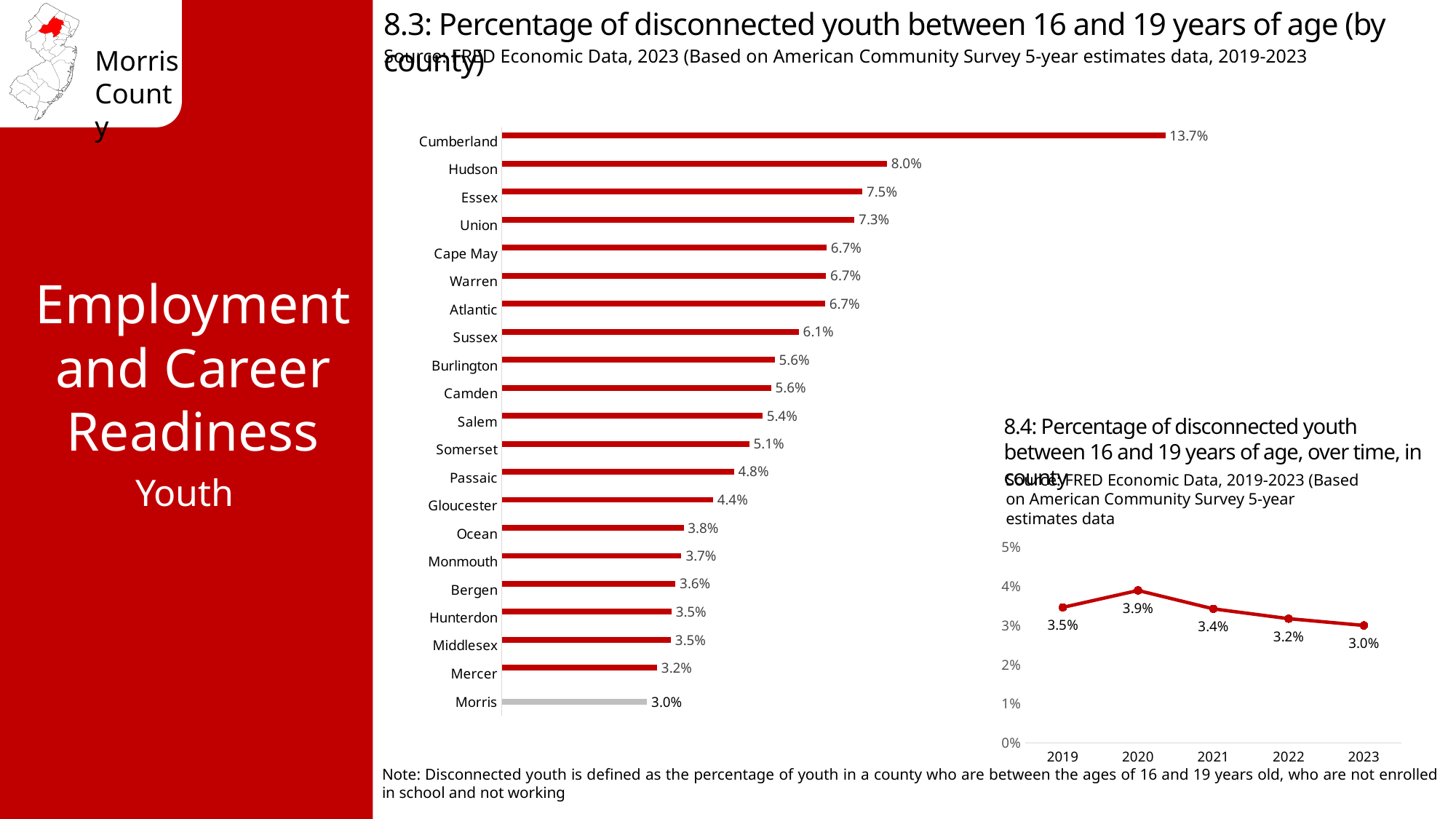
In the 8.3 bar chart (by county), which bar is coloured grey instead of red? Morris In the 8.3 bar chart (by county), which county has the highest percentage of disconnected youth? Cumberland What kind of chart is chart 8.3 (by county)? Bar chart In the 8.4 line chart (over time), what is the value for 2020? 3.9% In the 8.4 line chart (over time), which year has the lowest value? 2023 In the 8.3 bar chart (by county), which is larger, the value for Sussex or the value for Salem? Sussex How many counties are shown in the 8.3 bar chart (by county)? 21 In the 8.3 bar chart (by county), what is the value for Morris? 3.0% In the 8.3 bar chart (by county), what is the value for Cumberland? 13.7% In the 8.4 line chart (over time), do the values rise or fall from 2020 to 2023? Fall In the 8.3 bar chart (by county), what is the difference between Hudson and Essex? 0.5% In the 8.3 bar chart (by county), which county has the lowest percentage of disconnected youth? Morris